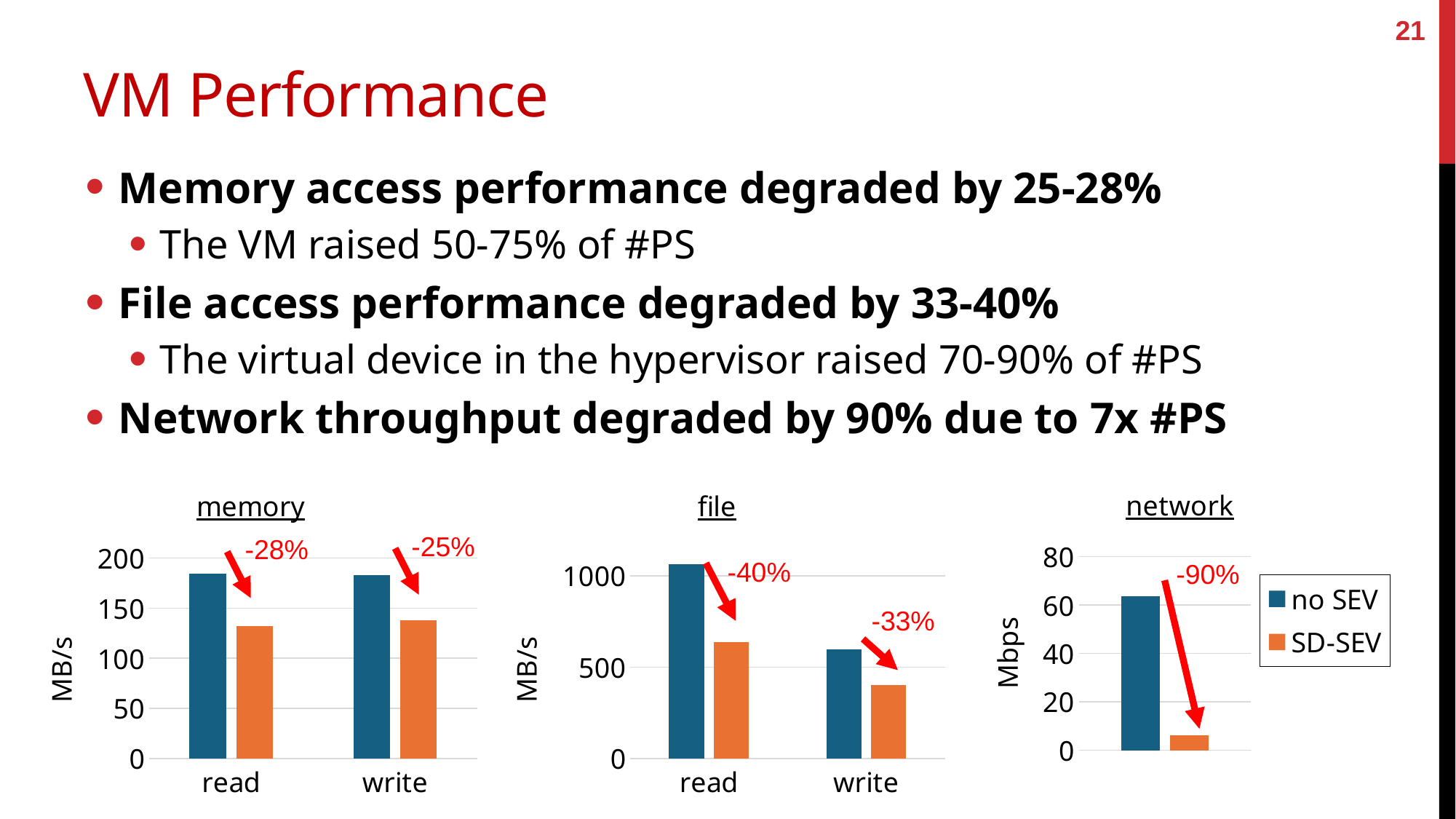
How many series does the legend list for the charts? 2 In the memory chart, what percentage change is annotated for read? -28% In the network chart, what percentage change is annotated? -90% In the file chart, is the SD-SEV value for write greater or less than 500? less In the file chart, what percentage change is annotated for read? -40% In the file chart, is the no SEV value for read greater or less than 1000? greater What kind of chart is the memory chart? bar chart What are the two series named in the legend? no SEV and SD-SEV In the file chart, what percentage change is annotated for write? -33% In the memory chart, what percentage change is annotated for write? -25% In the network chart, which series has the larger value, no SEV or SD-SEV? no SEV In the memory chart, is the no SEV value for read greater or less than 150? greater